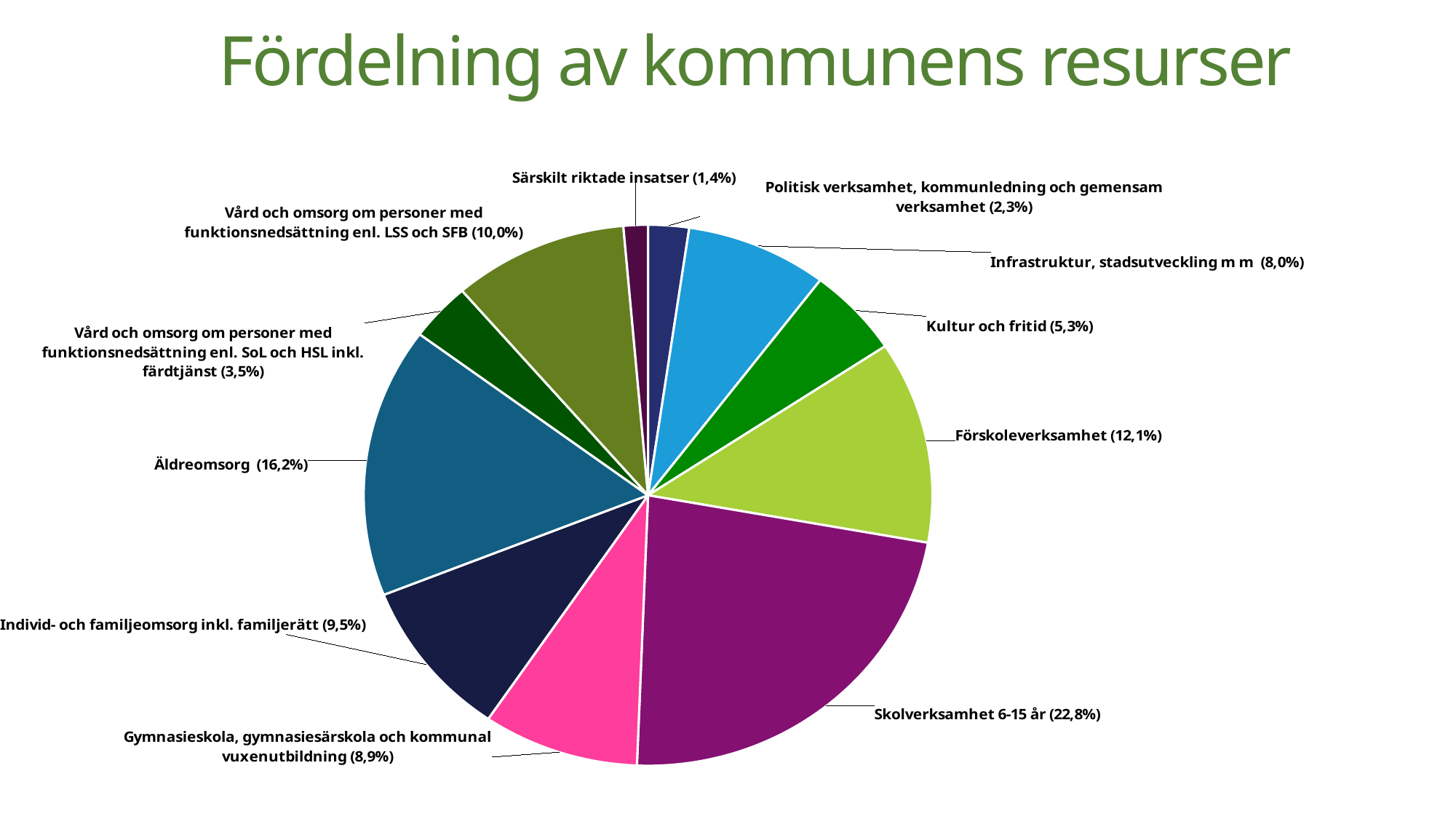
What kind of chart is shown on the slide? Pie chart Which category has the smallest share of the pie? Särskilt riktade insatser How many slices does the pie chart have? 11 What is the difference between the shares of Äldreomsorg and Förskoleverksamhet? 4,1% What is the value for Kultur och fritid? 5,3% Which category has the largest share of the pie? Skolverksamhet 6-15 år What share of the pie is Skolverksamhet 6-15 år? 22,8% What share of the pie is Äldreomsorg? 16,2% What is the title of the chart? Fördelning av kommunens resurser What is the value for Gymnasieskola, gymnasiesärskola och kommunal vuxenutbildning? 8,9% What is the value for Förskoleverksamhet? 12,1% Which is larger, Infrastruktur, stadsutveckling m m or Individ- och familjeomsorg inkl. familjerätt? Individ- och familjeomsorg inkl. familjerätt